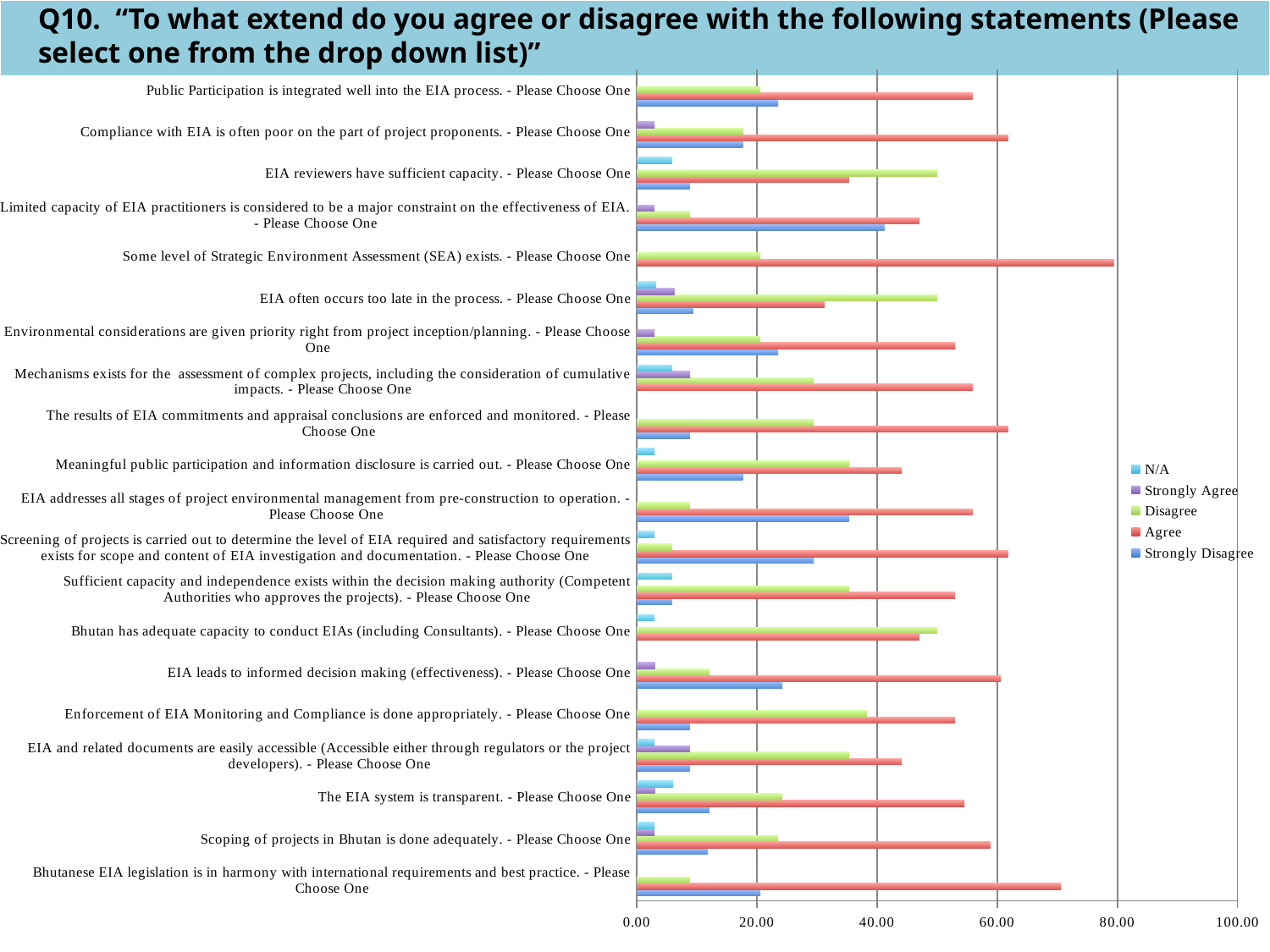
Which statement has the highest Agree value? Some level of Strategic Environment Assessment (SEA) exists. - Please Choose One Is the Strongly Disagree value for "EIA addresses all stages of project environmental management from pre-construction to operation" greater or less than 20.00? greater Which colour represents the Agree series in the legend? Red How many statements (categories) are plotted on the chart? 20 How many series does the legend list? 5 Which statement has the larger Agree value: "Compliance with EIA is often poor on the part of project proponents" or "Meaningful public participation and information disclosure is carried out"? Compliance with EIA is often poor on the part of project proponents Is the Disagree value for "EIA reviewers have sufficient capacity" greater or less than 40.00? greater What kind of chart is shown on the slide? Bar chart Is the Agree value for "Some level of Strategic Environment Assessment (SEA) exists" greater or less than 60.00? greater For "EIA often occurs too late in the process", which is larger: the Agree value or the Disagree value? Disagree